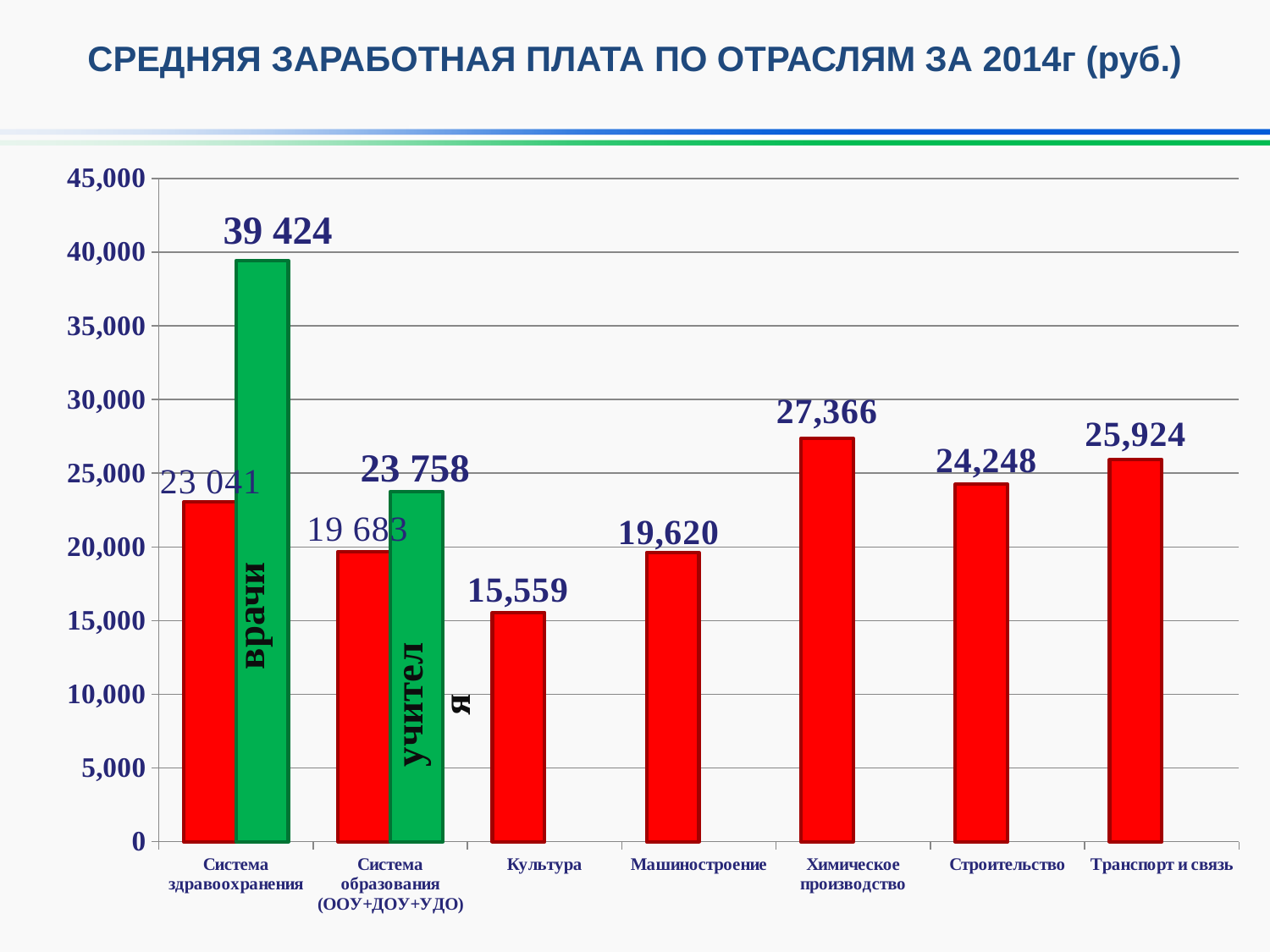
What is the average salary shown for Химическое производство? 27,366 Which bar has the highest value on the chart? врачи (Система здравоохранения) What is the average salary shown for Транспорт и связь? 25,924 What is the difference between the values for Химическое производство and Машиностроение? 7,746 What type of chart is shown on the slide? bar chart What value is shown on the red bar in the Система образования (ООУ+ДОУ+УДО) category? 19 683 What is the average salary shown for Культура? 15,559 Which category has the lowest average salary on the chart? Культура Which is larger, the value for Строительство or the value for Транспорт и связь? Транспорт и связь What is the average salary shown for Строительство? 24,248 What value is shown on the green bar labelled 'врачи' in the Система здравоохранения category? 39 424 How many categories are labelled on the x axis of the chart? 7